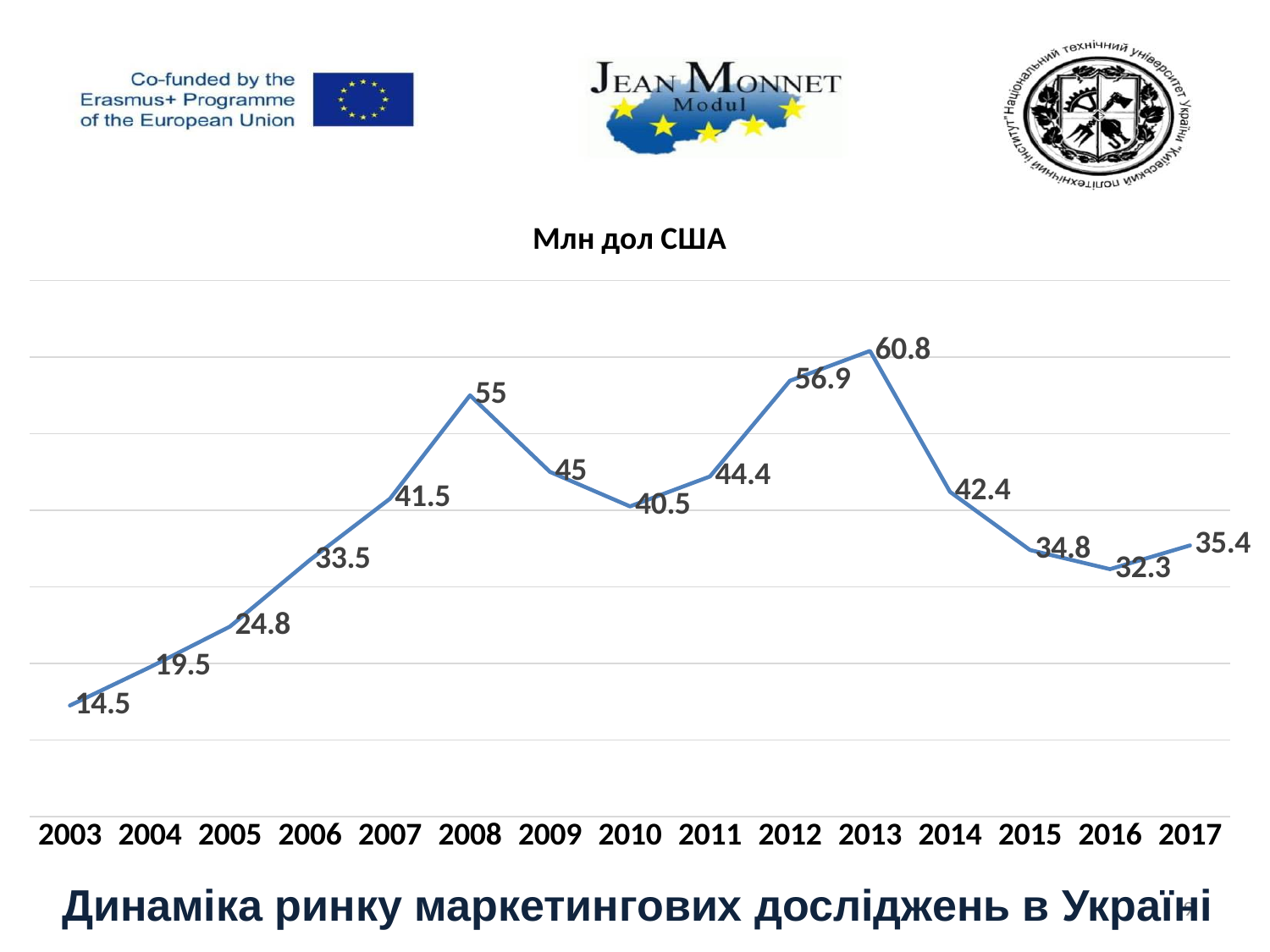
What is the value for 2013? 60.8 Do the values rise or fall from 2003 to 2008? rise What is the difference between the values for 2008 and 2009? 10 Which is larger, the value for 2012 or the value for 2009? 2012 What is the value for 2017? 35.4 How many years are plotted on the x axis? 15 Which year has the highest value? 2013 Which year has the lowest value? 2003 What is the difference between the values for 2013 and 2014? 18.4 What is the value for 2008? 55 What kind of chart is shown on the slide? line chart What is the value for 2003? 14.5